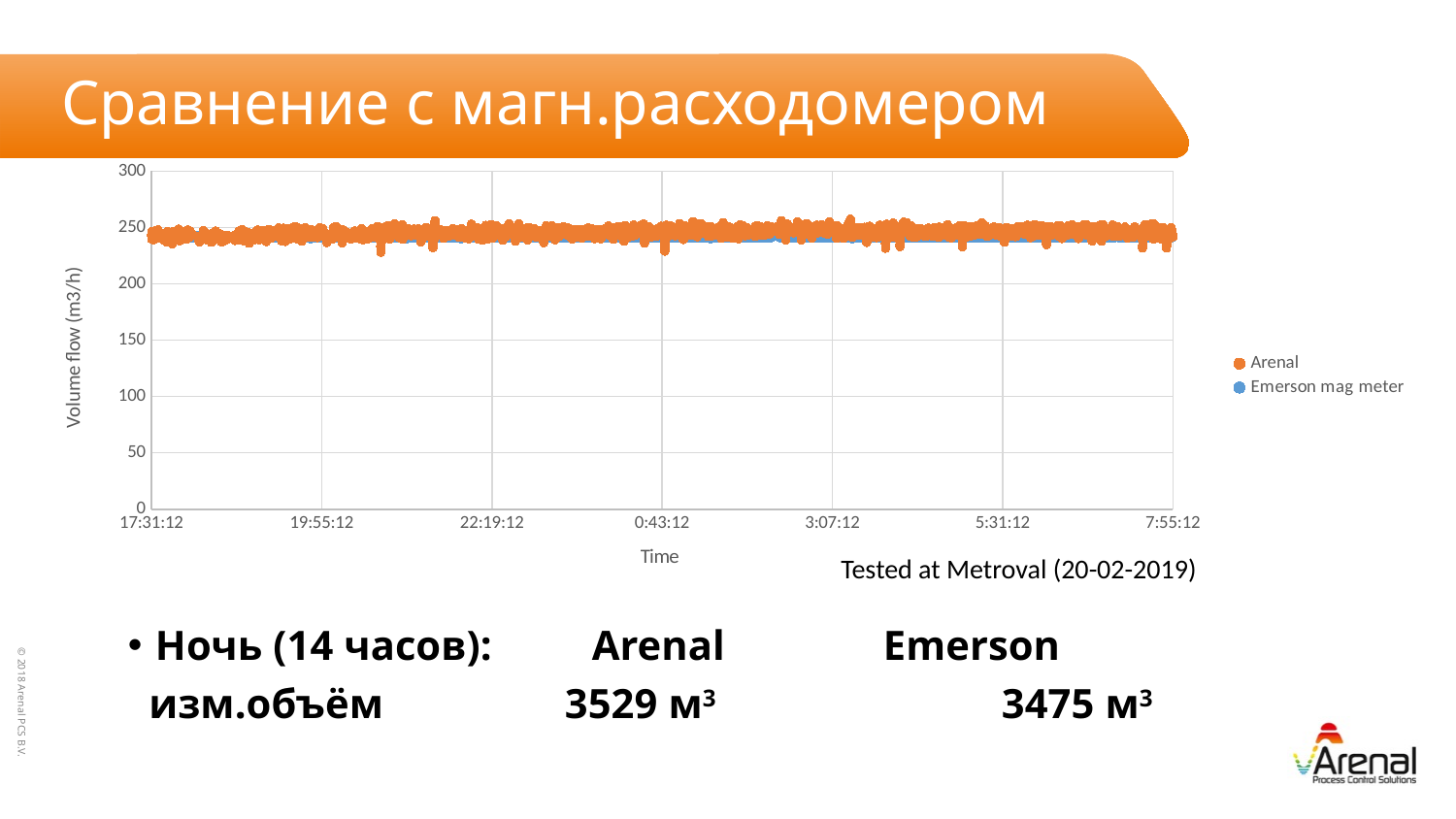
How many series does the chart legend list? 2 Which series is plotted in orange? Arenal Is the value for the Arenal series greater or less than 200 m3/h across the plotted period? greater Do the plotted values rise, fall, or stay roughly flat along the time axis? stay roughly flat What kind of chart is shown on the slide? scatter chart What is the title of the vertical axis? Volume flow (m3/h) Is the value for the Arenal series greater or less than 150 at 0:43:12? greater Is the value for the Emerson mag meter series greater or less than 300 m3/h? less